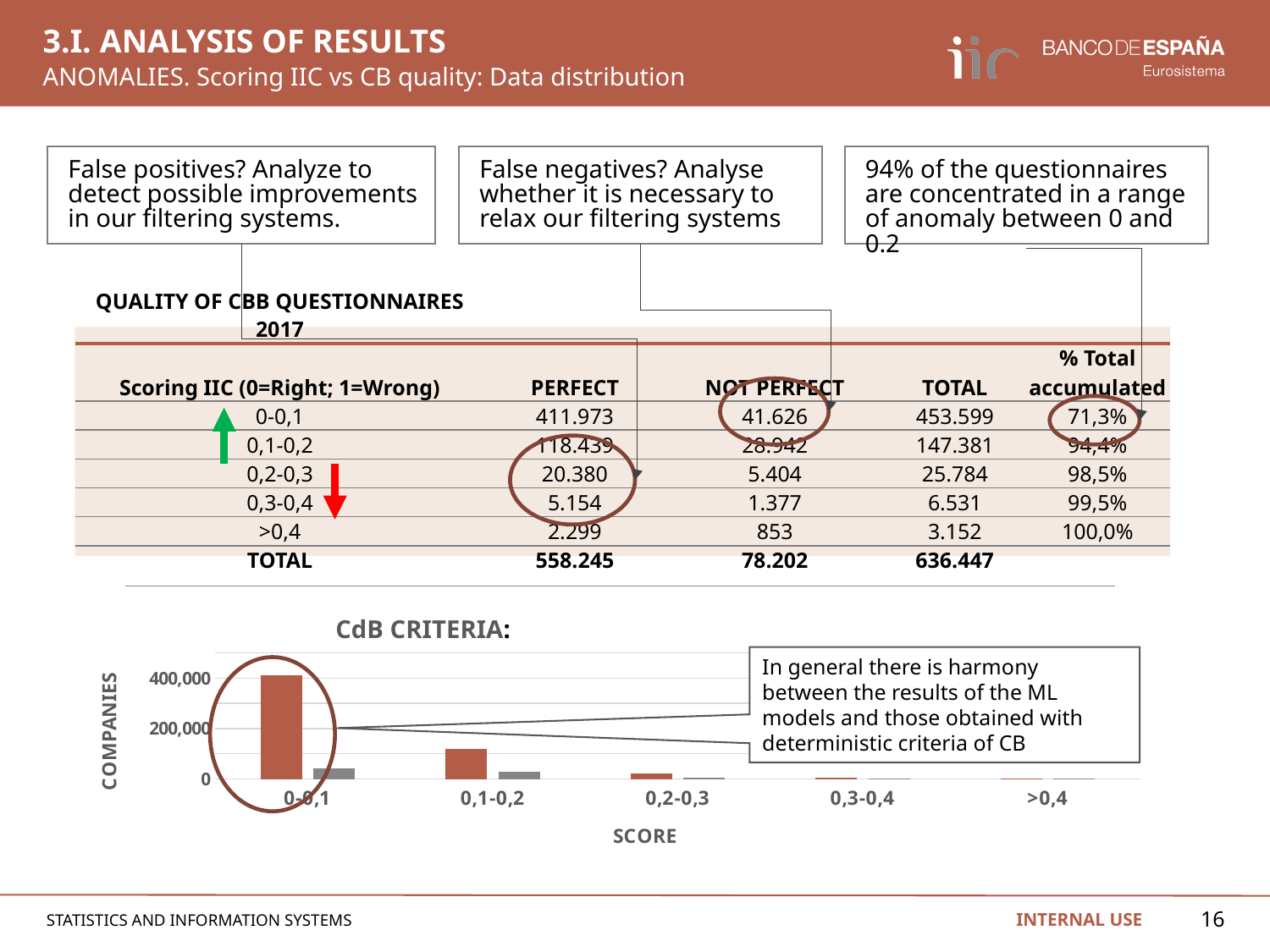
What type of chart is shown under the heading 'CdB CRITERIA:'? bar chart How many score categories are shown on the x axis of the CdB CRITERIA chart? 5 What is the title of the x axis of the CdB CRITERIA chart? SCORE How many bars are shown for each score category in the CdB CRITERIA chart? 2 In the CdB CRITERIA chart, do the bar heights rise or fall as the score increases along the x axis? fall Which score category has the lowest bars in the CdB CRITERIA chart? >0,4 What is the title of the y axis of the CdB CRITERIA chart? COMPANIES In the CdB CRITERIA chart, which has the taller orange bar: 0-0,1 or 0,1-0,2? 0-0,1 Which score category has the tallest bar in the CdB CRITERIA chart? 0-0,1 In the CdB CRITERIA chart, is the value of the tallest bar for 0,1-0,2 greater or less than 200,000? less In the CdB CRITERIA chart, is the value of the tallest bar for 0-0,1 greater or less than 200,000? greater